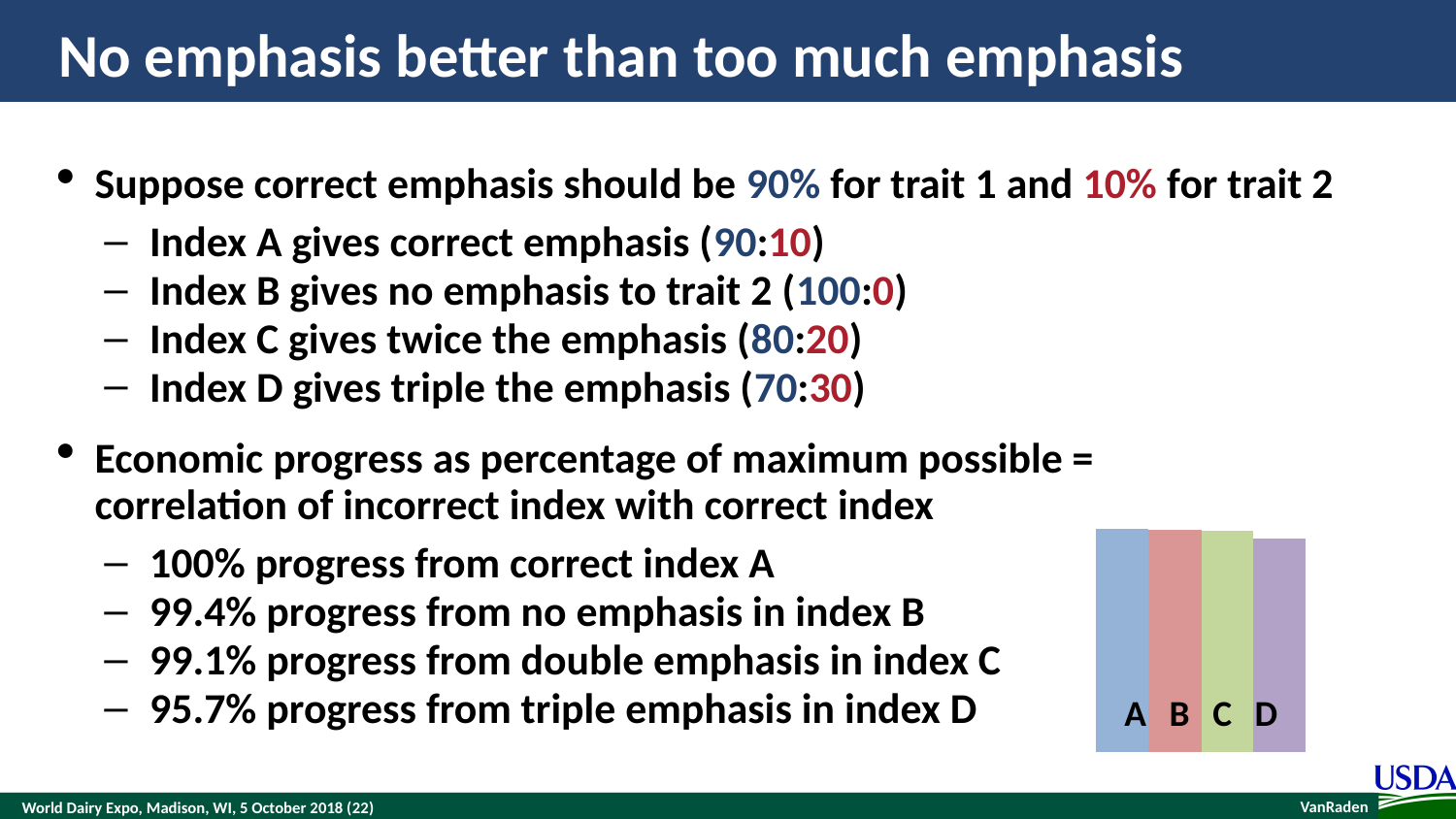
What percentage of maximum possible economic progress does index D achieve? 95.7% What percentage of maximum possible economic progress does index B achieve? 99.4% What colour is the bar for index C? green What colour is the bar for index A? blue What kind of chart is shown on the slide? bar chart What percentage of maximum possible economic progress does index C achieve? 99.1% Is the bar for index A taller or shorter than the bar for index D? taller Which index has the shortest bar in the chart? D How many bars does the chart show? 4 What percentage of maximum possible economic progress does index A achieve? 100% Which index has the tallest bar in the chart? A What is the difference in progress between index A and index D? 4.3%